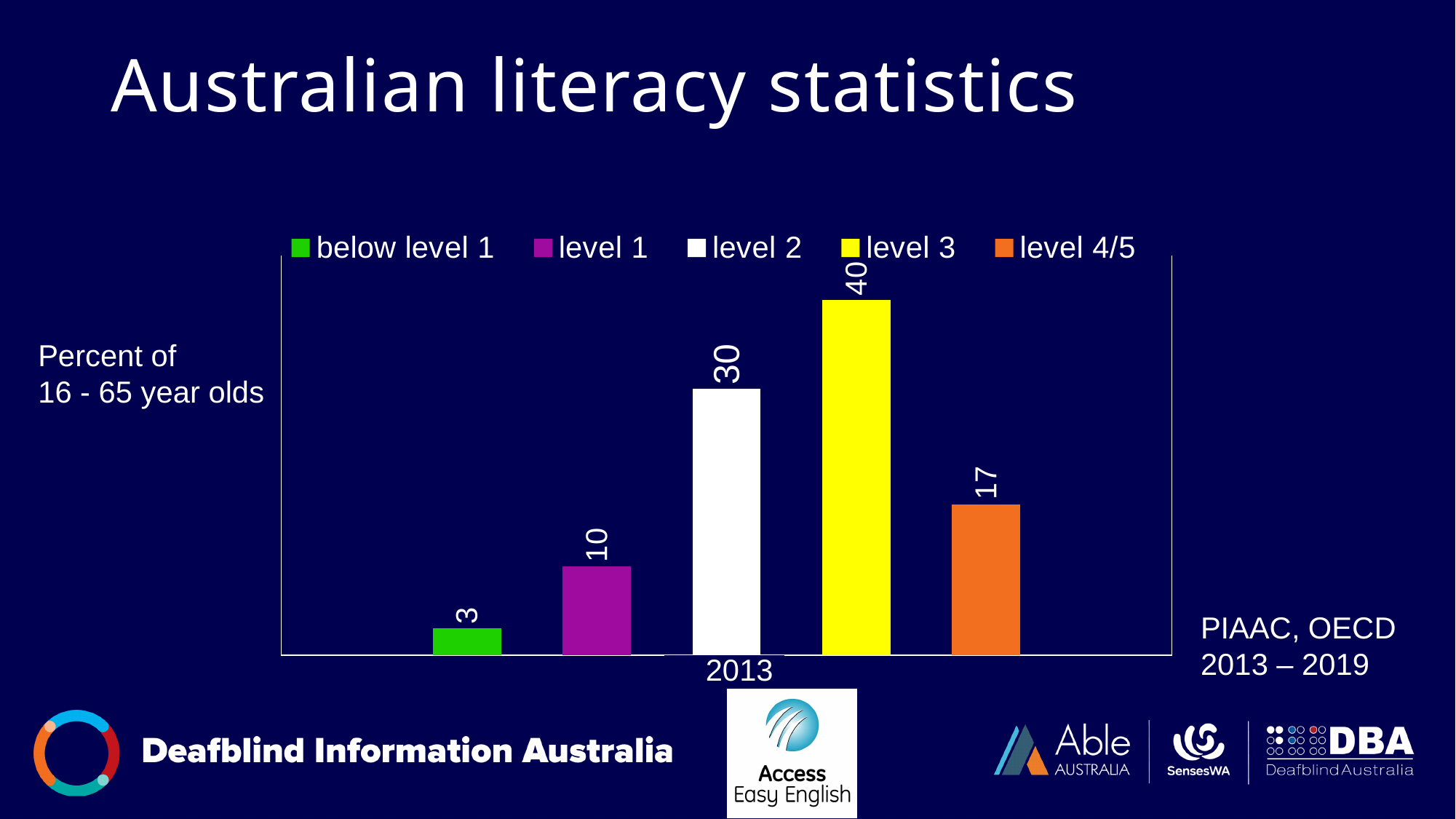
What is the difference between the values for level 4/5 and level 1? 7 What is the difference between the values for level 3 and level 2? 10 What is the value for below level 1? 3 Which series has the lowest value? below level 1 Which series has the highest value? level 3 What year is labelled on the x axis of the chart? 2013 How many series does the legend list? 5 Which is larger, the value for level 2 or the value for level 4/5? level 2 What is the value for level 4/5? 17 What is the value for level 3? 40 What kind of chart is shown on the slide? bar chart What is the value for level 1? 10